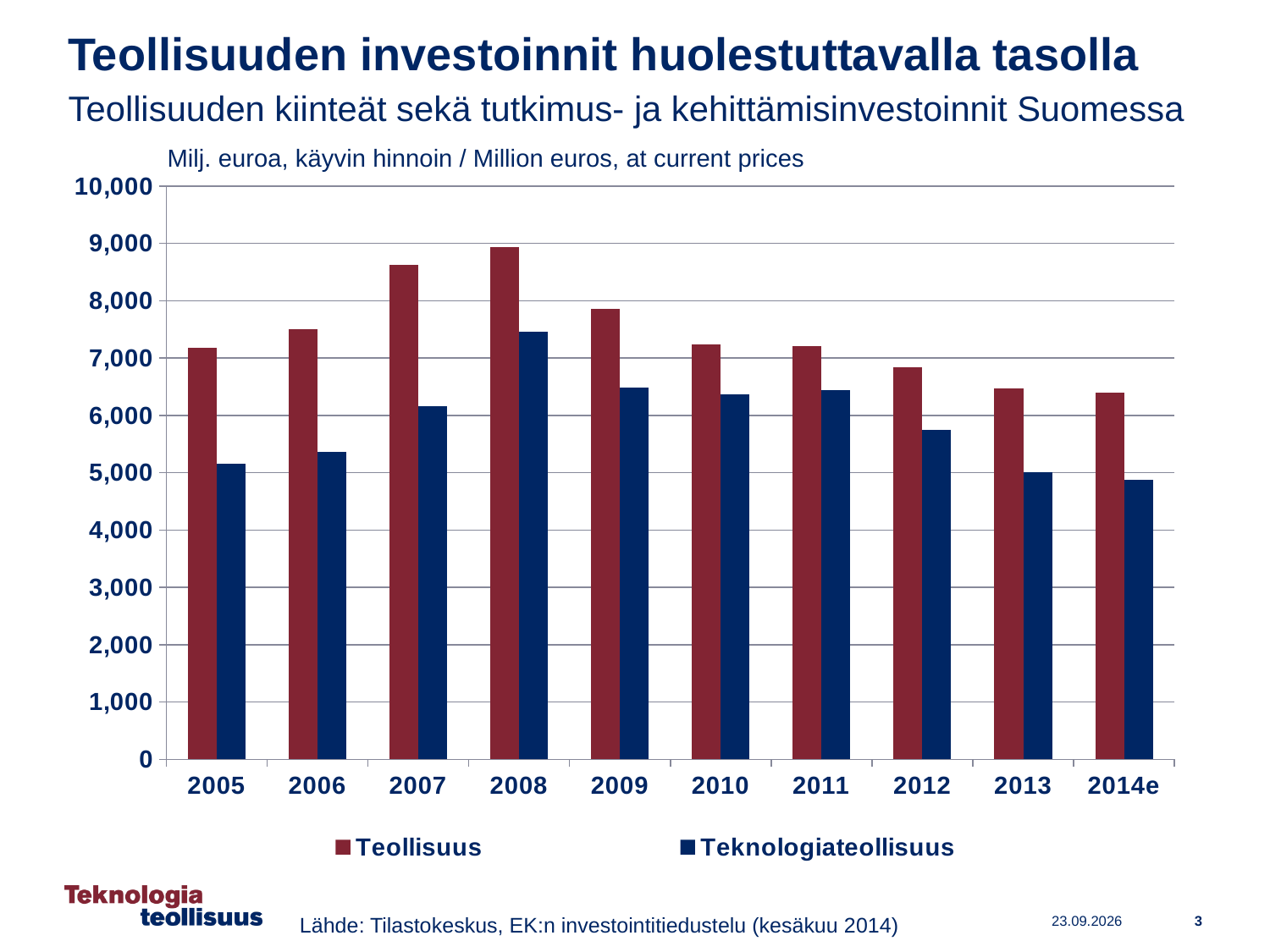
In which year is the Teknologiateollisuus value highest? 2008 Is the Teollisuus value for 2012 greater or less than 7,000? less In which year is the Teknologiateollisuus value lowest? 2014e How many series does the legend list? 2 In which year is the Teollisuus value highest? 2008 Is the Teknologiateollisuus value for 2014e greater or less than 5,000? less Do the Teollisuus values rise or fall from 2008 to 2014e? fall Is the Teollisuus value for 2008 greater or less than 8,000? greater Which is larger, the Teollisuus value for 2007 or for 2009? 2007 What kind of chart is shown on the slide? Bar chart How many years are shown on the x axis? 10 What unit is stated above the chart? Milj. euroa, käyvin hinnoin / Million euros, at current prices